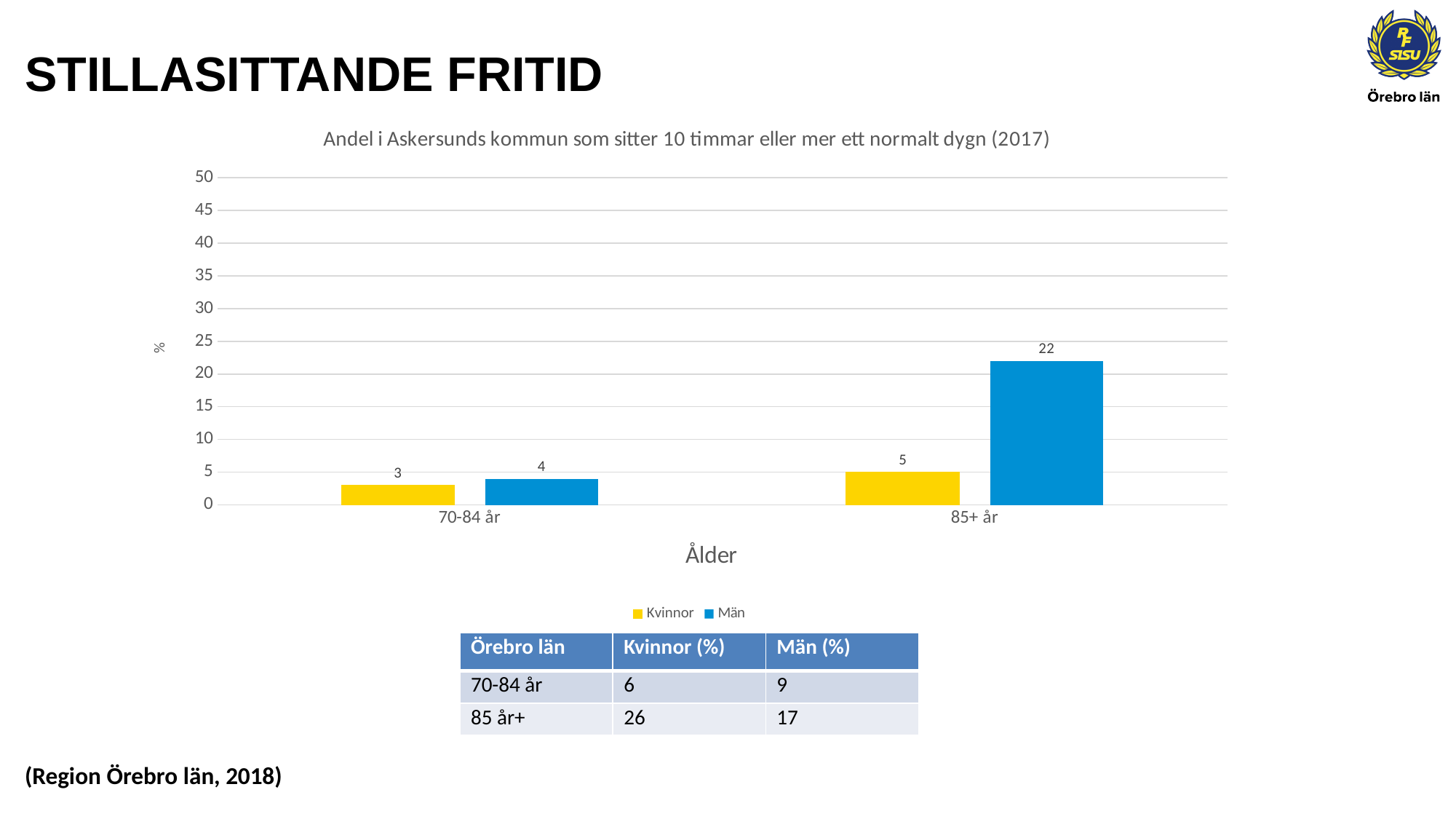
Which is larger in the 70-84 år category, Kvinnor or Män? Män Which bar has the lowest value in the chart? Kvinnor, 70-84 år What is the value for Män in the 85+ år category? 22 What is the value for Kvinnor in the 70-84 år category? 3 What is the value for Män in the 70-84 år category? 4 What is the value for Kvinnor in the 85+ år category? 5 What kind of chart is shown on the slide? Bar chart Which bar has the highest value in the chart? Män, 85+ år How many series does the legend list? 2 What is the difference between Män and Kvinnor in the 85+ år category? 17 Is the value for Män in the 85+ år category greater or less than 20? greater How many age categories are shown on the x axis? 2